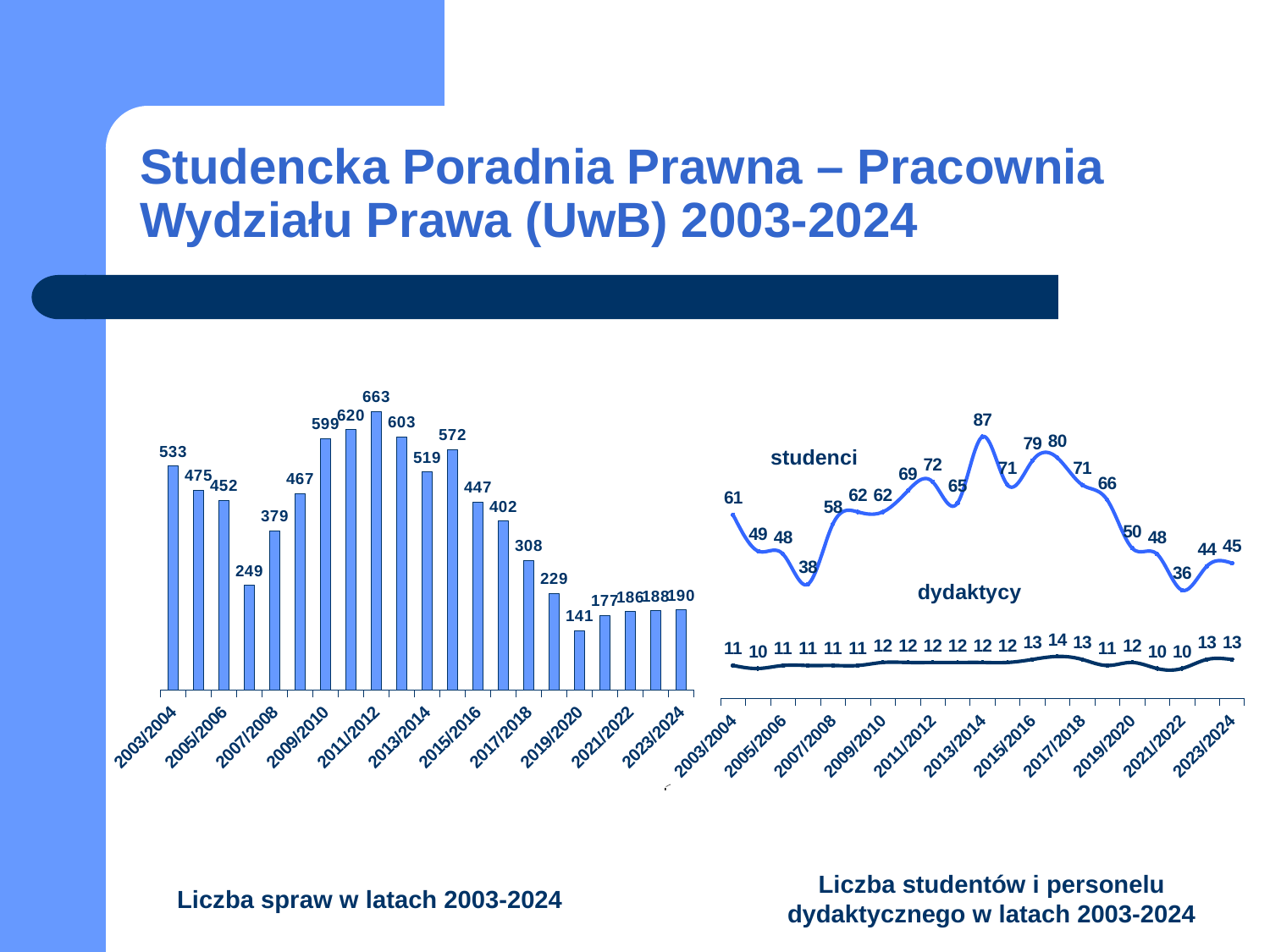
In the chart 'Liczba studentów i personelu dydaktycznego w latach 2003-2024', what is the value of 'studenci' for 2013/2014? 87 In the chart 'Liczba studentów i personelu dydaktycznego w latach 2003-2024', what is the value of 'dydaktycy' for 2023/2024? 13 In the chart 'Liczba spraw w latach 2003-2024', what is the difference between the values for 2011/2012 and 2023/2024? 473 In the chart 'Liczba spraw w latach 2003-2024', which year has the lowest number of cases? 2019/2020 In the chart 'Liczba studentów i personelu dydaktycznego w latach 2003-2024', what is the difference between the 'studenci' values for 2013/2014 and 2021/2022? 51 In the chart 'Liczba spraw w latach 2003-2024', which year has the highest number of cases? 2011/2012 In the chart 'Liczba spraw w latach 2003-2024', what kind of chart is shown? bar chart In the chart 'Liczba studentów i personelu dydaktycznego w latach 2003-2024', which year has the lowest 'studenci' value? 2021/2022 In the chart 'Liczba studentów i personelu dydaktycznego w latach 2003-2024', how many series are plotted? 2 In the chart 'Liczba studentów i personelu dydaktycznego w latach 2003-2024', which is larger for 2003/2004: 'studenci' or 'dydaktycy'? studenci In the chart 'Liczba spraw w latach 2003-2024', how many bars are plotted? 21 In the chart 'Liczba spraw w latach 2003-2024', what is the value for 2003/2004? 533